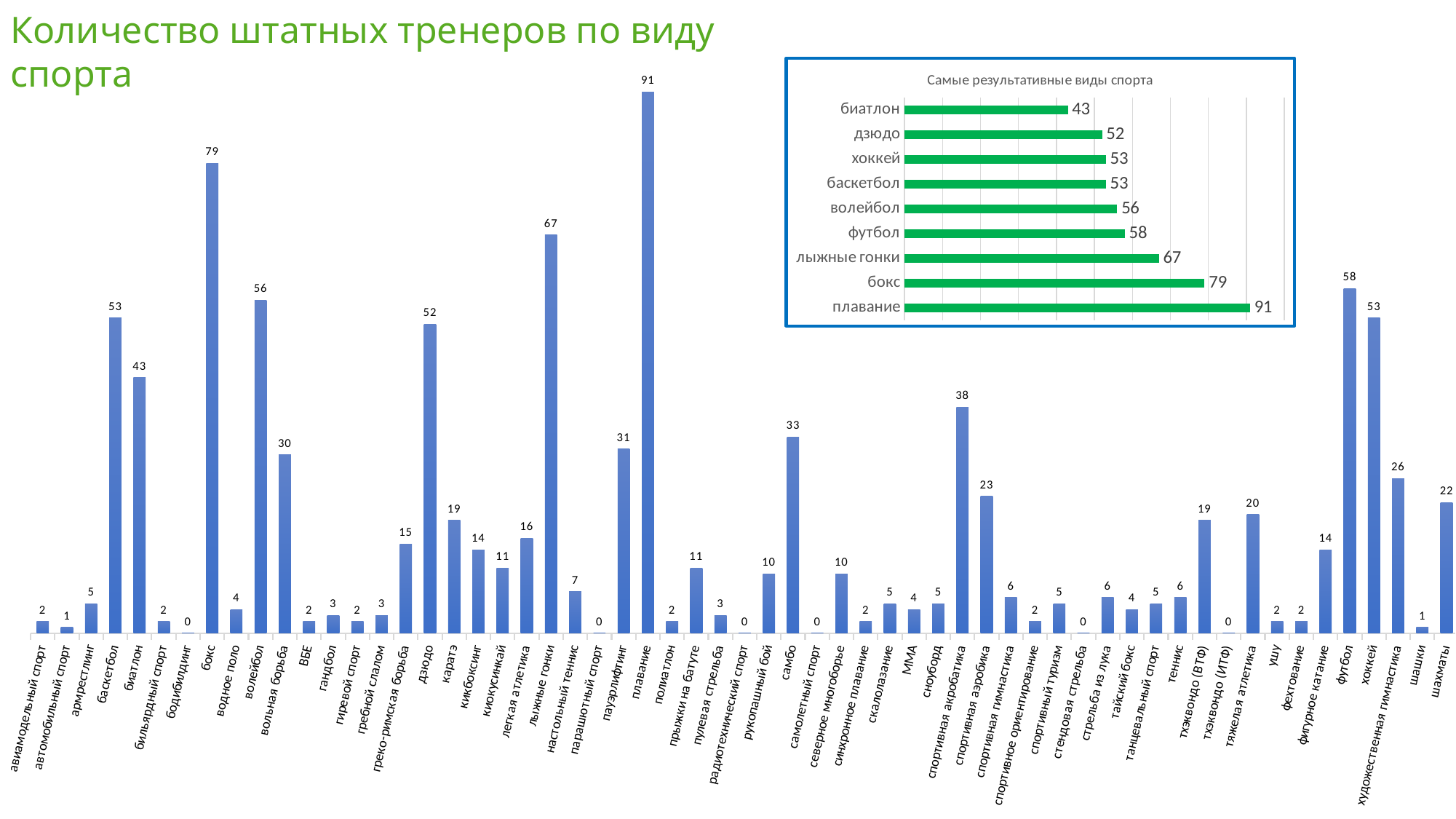
In the inset chart 'Самые результативные виды спорта', what is the value for волейбол? 56 In the chart 'Количество штатных тренеров по виду спорта', which sport has the highest value? плавание In the chart 'Количество штатных тренеров по виду спорта', what is the value for плавание? 91 In the chart 'Количество штатных тренеров по виду спорта', what is the difference between бокс and лыжные гонки? 12 In the chart 'Количество штатных тренеров по виду спорта', which is larger: самбо or пауэрлифтинг? самбо What type of chart is the inset chart 'Самые результативные виды спорта'? bar chart In the inset chart 'Самые результативные виды спорта', which sport has the lowest value? биатлон In the inset chart 'Самые результативные виды спорта', what is the difference between плавание and дзюдо? 39 In the chart 'Количество штатных тренеров по виду спорта', what is the value for тяжелая атлетика? 20 In the chart 'Количество штатных тренеров по виду спорта', what is the value for спортивная акробатика? 38 In the chart 'Количество штатных тренеров по виду спорта', what is the value for художественная гимнастика? 26 In the inset chart 'Самые результативные виды спорта', how many sports are listed? 9